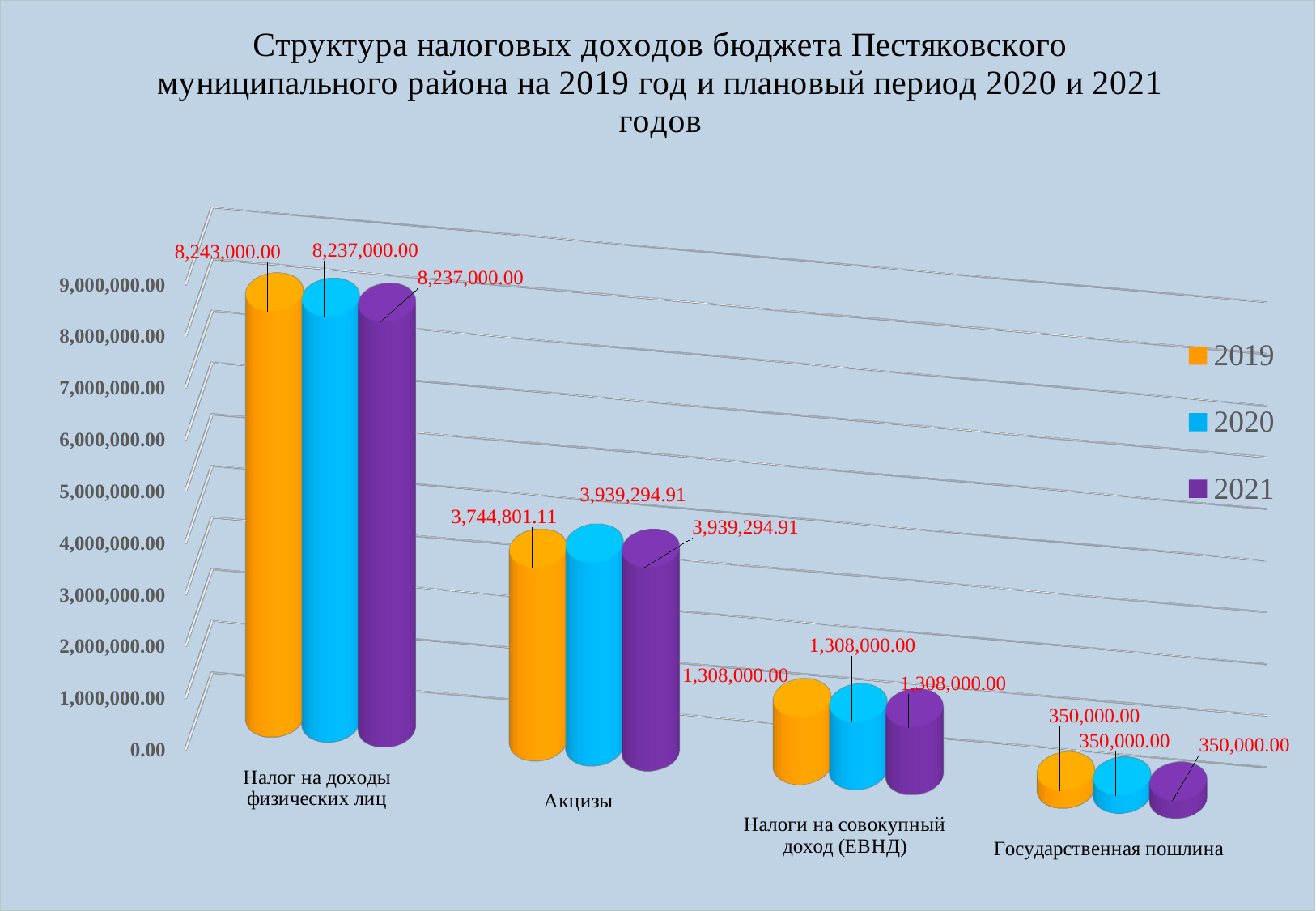
Which category has the lowest value in 2021? Государственная пошлина Which is larger: the 2019 value for Налог на доходы физических лиц or the 2021 value for Налог на доходы физических лиц? 2019 What is the value for Налог на доходы физических лиц in 2019? 8,243,000.00 What is the value for Государственная пошлина in 2019? 350,000.00 How many series does the legend list? 3 What is the value for Акцизы in 2020? 3,939,294.91 Is the 2019 value for Акцизы greater or less than 3,000,000.00? greater What is the value for Налоги на совокупный доход (ЕВНД) in 2021? 1,308,000.00 What is the difference between the 2020 and 2019 values for Акцизы? 194,493.80 What kind of chart is shown on the slide? bar chart How many categories are shown on the x axis? 4 Which category has the highest value in 2019? Налог на доходы физических лиц